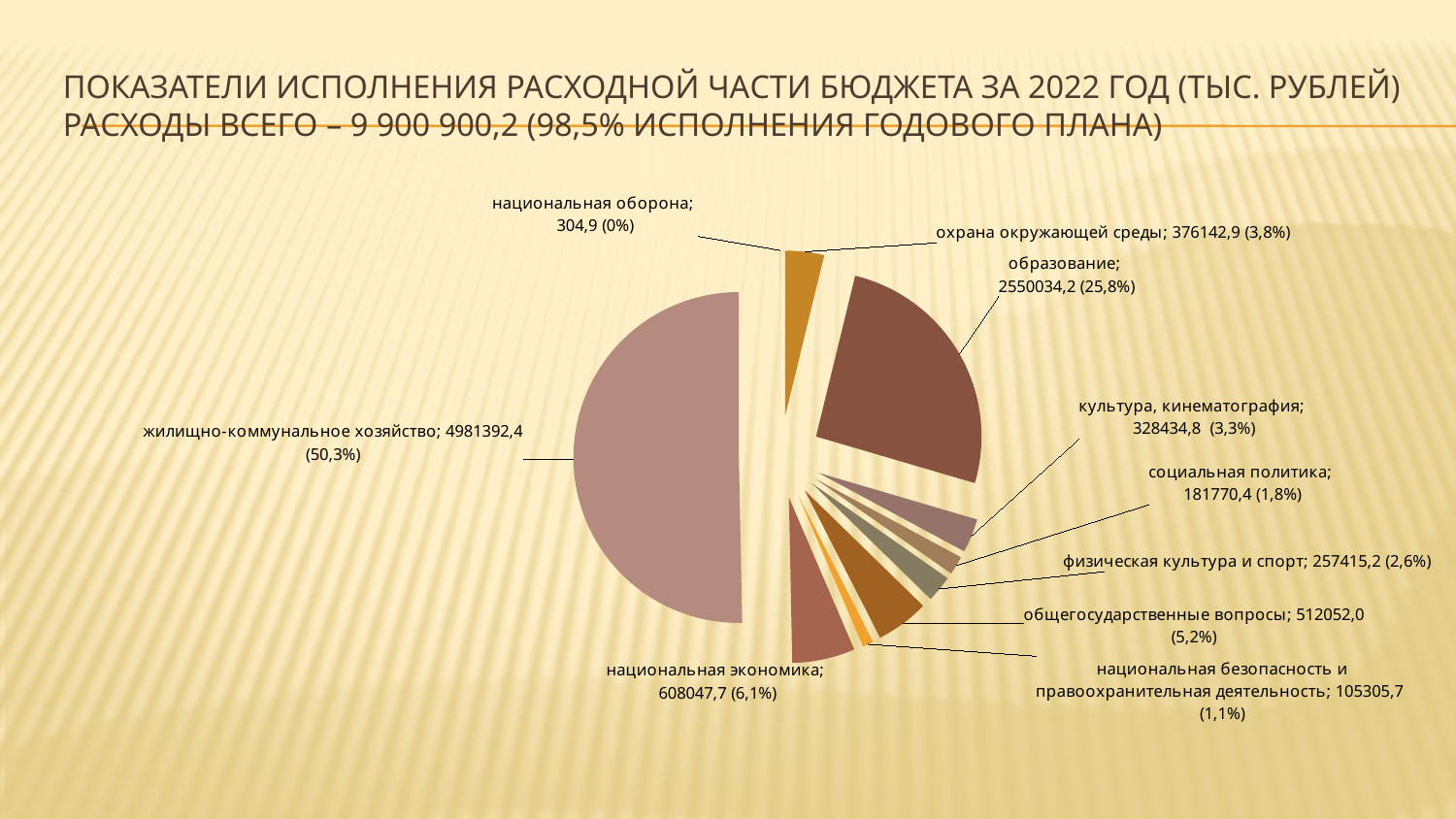
What is the value shown for национальная экономика? 608047,7 What share of the pie does охрана окружающей среды represent? 3,8% What is the value shown for социальная политика? 181770,4 Which category has the smallest slice of the pie chart? национальная оборона How many categories (slices) does the pie chart show? 10 What is the difference between the values for образование and охрана окружающей среды? 2173891,3 Which category has the largest slice of the pie chart? жилищно-коммунальное хозяйство What share of the pie does жилищно-коммунальное хозяйство represent? 50,3% Which is larger: the value for национальная экономика or for общегосударственные вопросы? национальная экономика What kind of chart is shown on the slide? Pie chart What is the value shown for образование? 2550034,2 What year does the chart title say the budget expenditure figures refer to? 2022